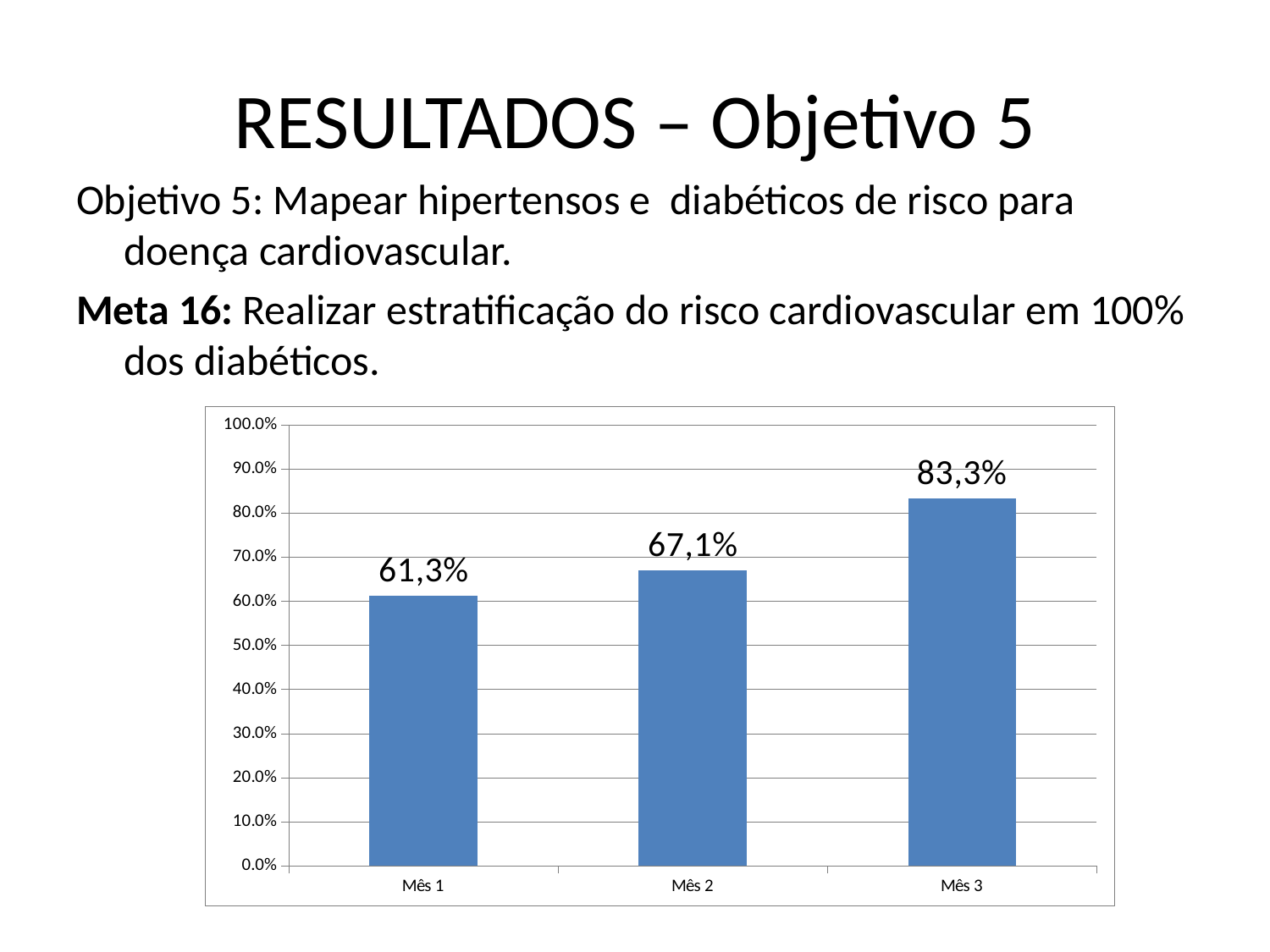
Do the values rise or fall from Mês 1 to Mês 3? Rise Which month has the highest value? Mês 3 How many categories are shown on the x axis? 3 Which month has the lowest value? Mês 1 What is the difference between the values for Mês 3 and Mês 1? 22 percentage points What is the value for Mês 2? 67,1% What is the difference between the values for Mês 2 and Mês 1? 5,8 percentage points What kind of chart is shown on the slide? Bar chart What is the value for Mês 3? 83,3% Is the value for Mês 3 greater or less than 80.0%? greater What is the value for Mês 1? 61,3% Which is larger, the value for Mês 2 or the value for Mês 3? Mês 3